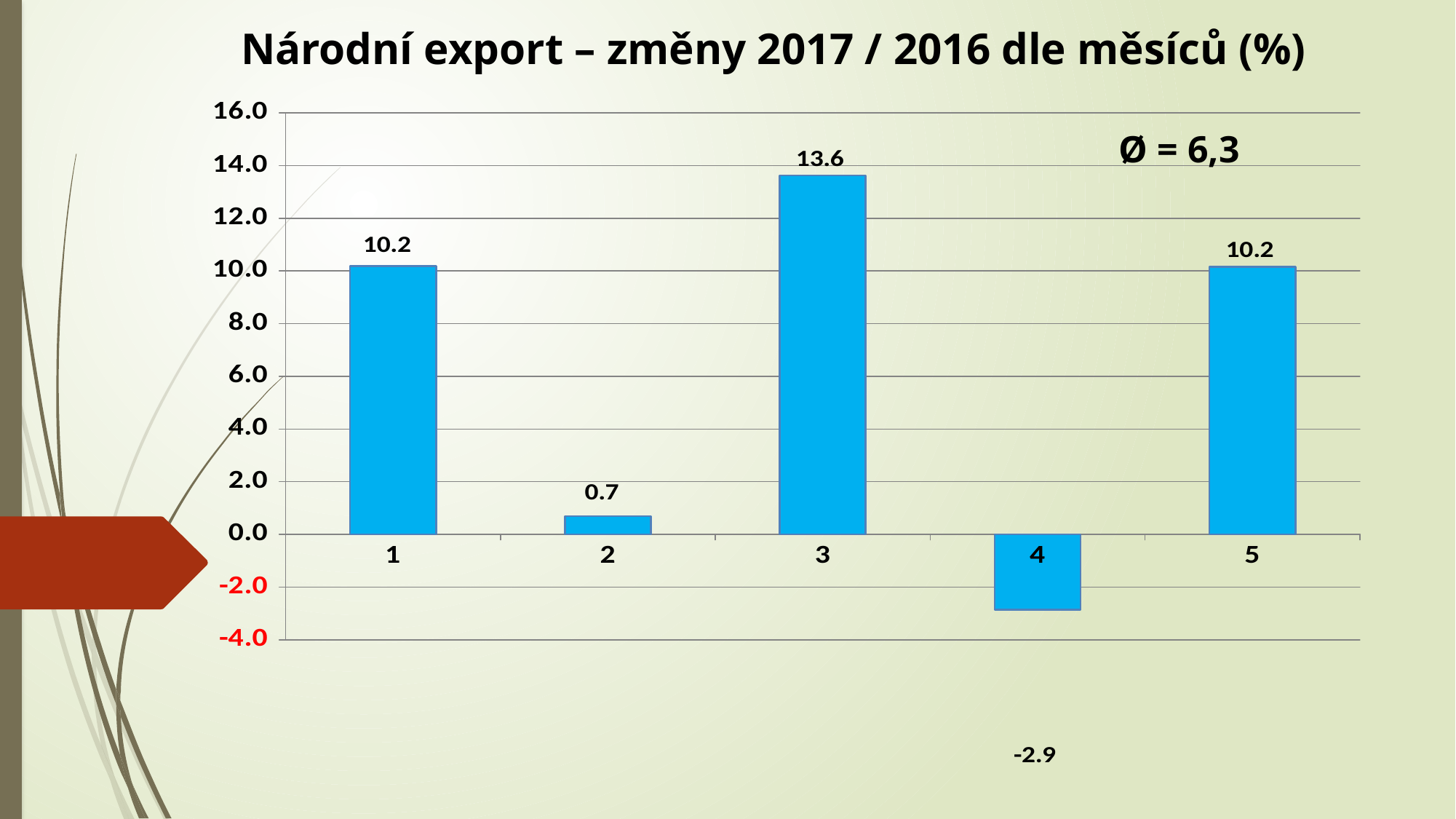
Which is larger, the value for month 2 or the value for month 5? month 5 What is the difference between the values for month 3 and month 1? 3.4 Which month has the lowest value? 4 Is the value for month 3 greater or less than 12.0? greater How many months are shown on the x axis? 5 Which month has the highest value? 3 What kind of chart is shown on the slide? bar chart What is the value for month 3? 13.6 What average value (Ø) is printed on the chart? 6,3 What is the value for month 4? -2.9 What is the value for month 2? 0.7 What is the value for month 1? 10.2